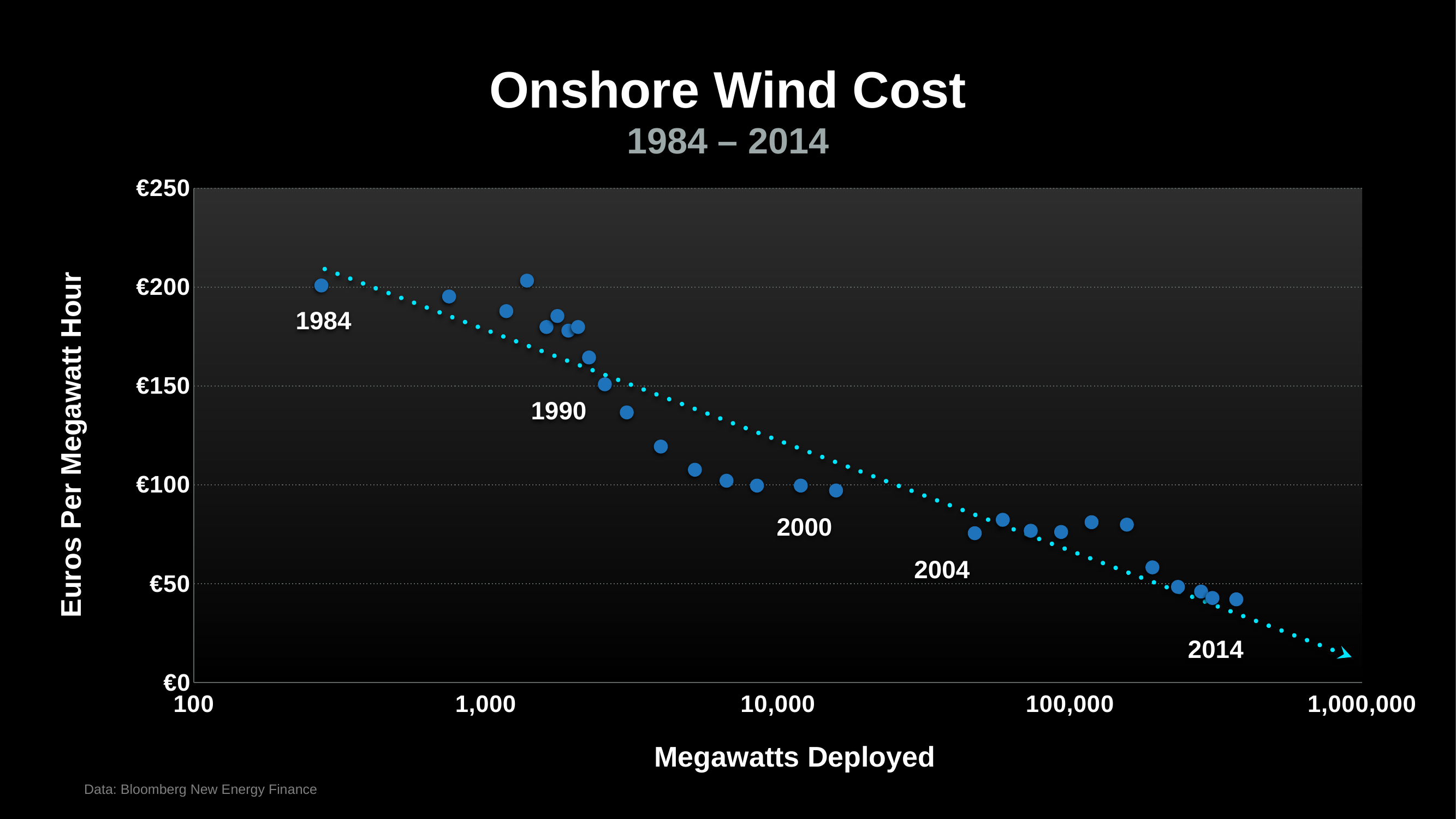
Is the value for the 1984 point greater or less than €150? greater Is the value for the 2014 point greater or less than €100? less Which has the higher cost per megawatt hour, the 1984 point or the 2014 point? 1984 Is the value for the 1990 point greater or less than €100? greater Which has the lower cost per megawatt hour, the 1990 point or the 2004 point? 2004 Do the cost values rise or fall as megawatts deployed increase along the x axis? fall What is the title of the chart? Onshore Wind Cost What is the label of the x axis? Megawatts Deployed What kind of chart is shown on the slide? scatter chart